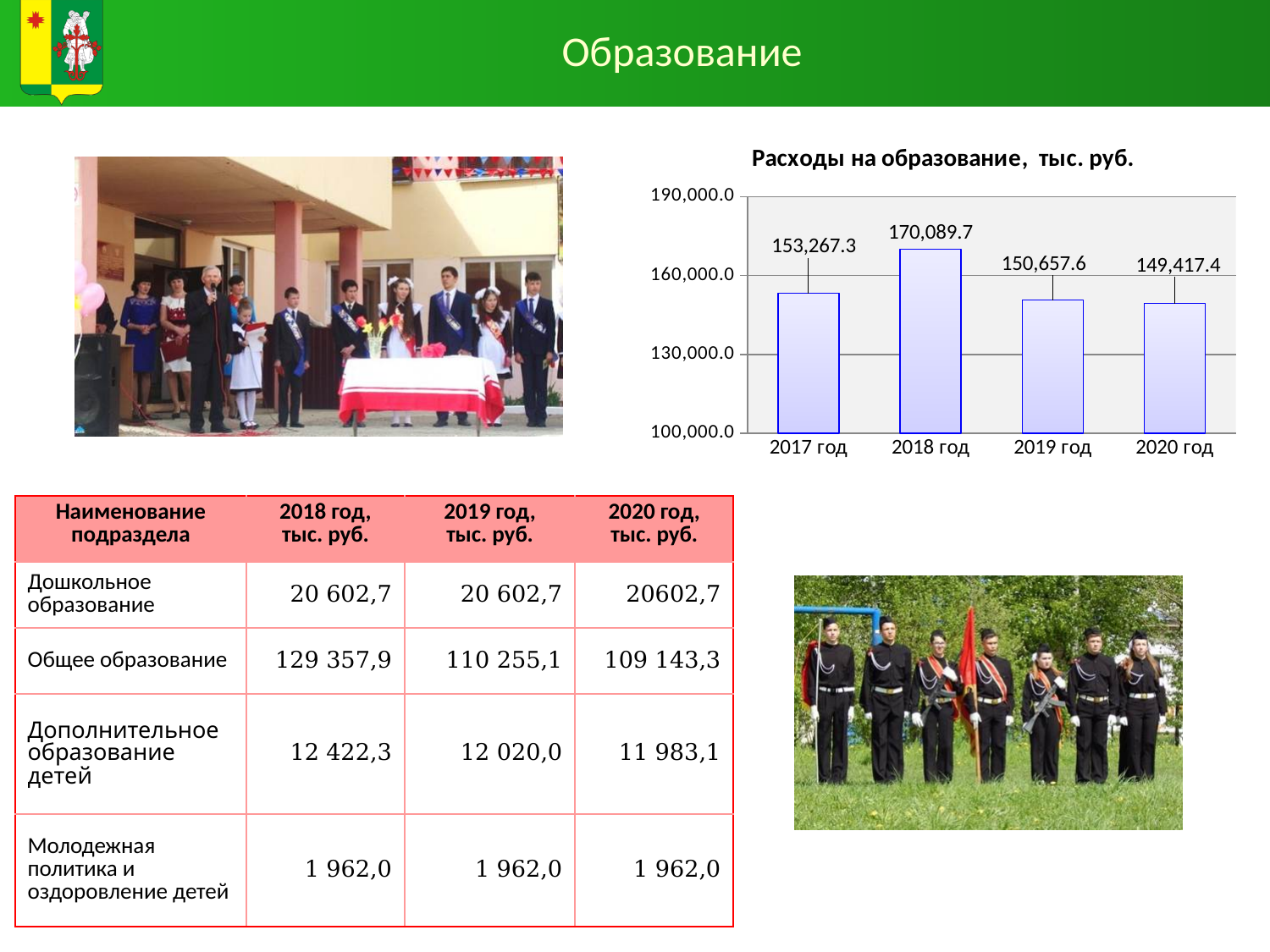
How many years are shown in the chart 'Расходы на образование, тыс. руб.'? 4 What is the value for 2020 год in the chart 'Расходы на образование, тыс. руб.'? 149,417.4 What kind of chart is 'Расходы на образование, тыс. руб.'? bar chart In the chart 'Расходы на образование, тыс. руб.', do the values rise or fall from 2018 год to 2020 год? fall What is the value for 2018 год in the chart 'Расходы на образование, тыс. руб.'? 170,089.7 In the chart 'Расходы на образование, тыс. руб.', which is larger: the value for 2017 год or the value for 2019 год? 2017 год Which year has the highest value in the chart 'Расходы на образование, тыс. руб.'? 2018 год Which year has the lowest value in the chart 'Расходы на образование, тыс. руб.'? 2020 год What is the difference between the values for 2018 год and 2017 год in the chart 'Расходы на образование, тыс. руб.'? 16,822.4 What is the value for 2017 год in the chart 'Расходы на образование, тыс. руб.'? 153,267.3 Is the value for 2018 год in the chart 'Расходы на образование, тыс. руб.' greater or less than 160,000.0? greater What is the difference between the values for 2019 год and 2020 год in the chart 'Расходы на образование, тыс. руб.'? 1,240.2